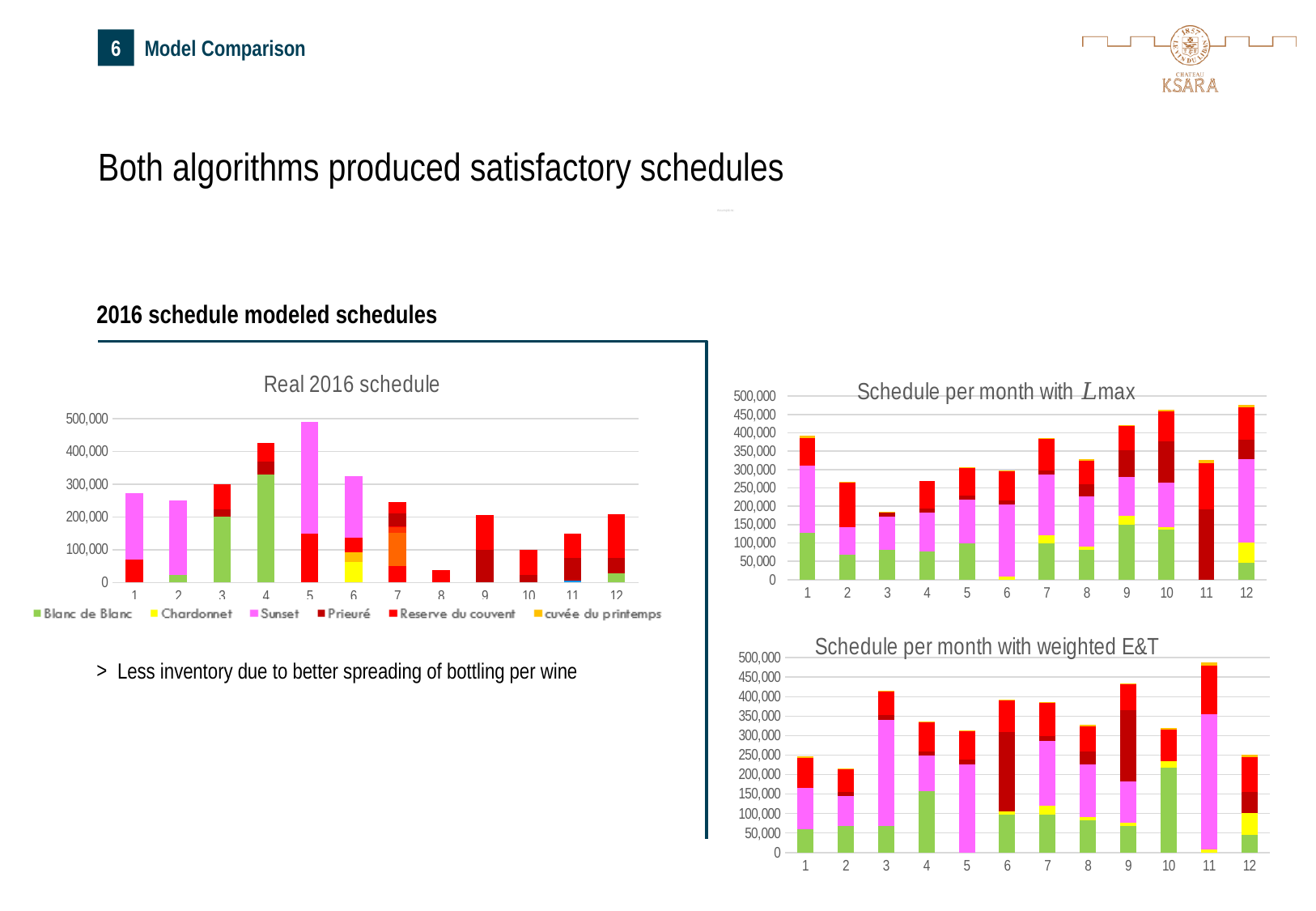
In the "Schedule per month with Lmax" chart, which month has the shortest stacked bar? 3 In the "Real 2016 schedule" chart, which month has the tallest stacked bar? 5 In the "Real 2016 schedule" chart, is the total for month 8 greater or less than 100,000? less In the "Schedule per month with weighted E&T" chart, which has the larger total, month 6 or month 2? Month 6 What kind of chart is the "Real 2016 schedule" chart? Stacked bar chart How many series does the legend of the "Real 2016 schedule" chart list? 6 How many months (categories) are shown on the x axis of the "Real 2016 schedule" chart? 12 In the "Real 2016 schedule" chart, which month has the shortest stacked bar? 8 In the "Schedule per month with Lmax" chart, is the total for month 11 greater or less than 300,000? greater In the "Schedule per month with weighted E&T" chart, which month has the tallest stacked bar? 11 In the "Real 2016 schedule" chart, what colour represents the Sunset series? Pink In the "Real 2016 schedule" chart, is the total for month 5 greater or less than 400,000? greater